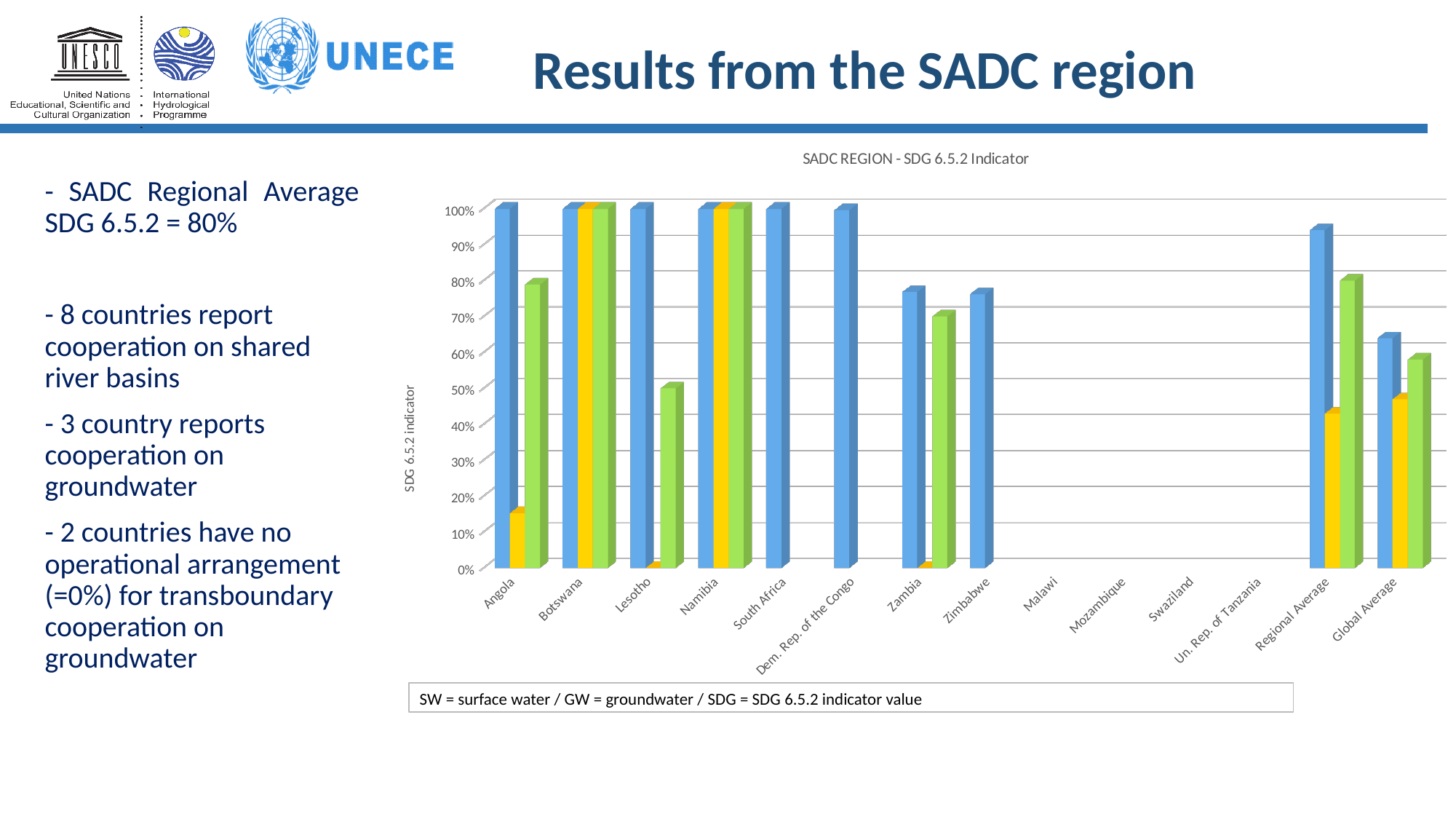
Which has the larger blue bar, Regional Average or Global Average? Regional Average Which is larger for Angola, the blue bar or the yellow bar? the blue bar What is the title of the chart? SADC REGION - SDG 6.5.2 Indicator How many categories are shown along the x axis of the chart? 14 What kind of chart is shown on the slide? bar chart What is the label of the vertical axis of the chart? SDG 6.5.2 indicator Is the value of the blue bar for Zambia greater or less than 70%? greater Is the value of the yellow bar for Regional Average greater or less than 50%? less What is the value of the blue bar for South Africa? 100% What is the value of the blue bar for Botswana? 100% Is the value of the blue bar for Regional Average greater or less than 90%? greater